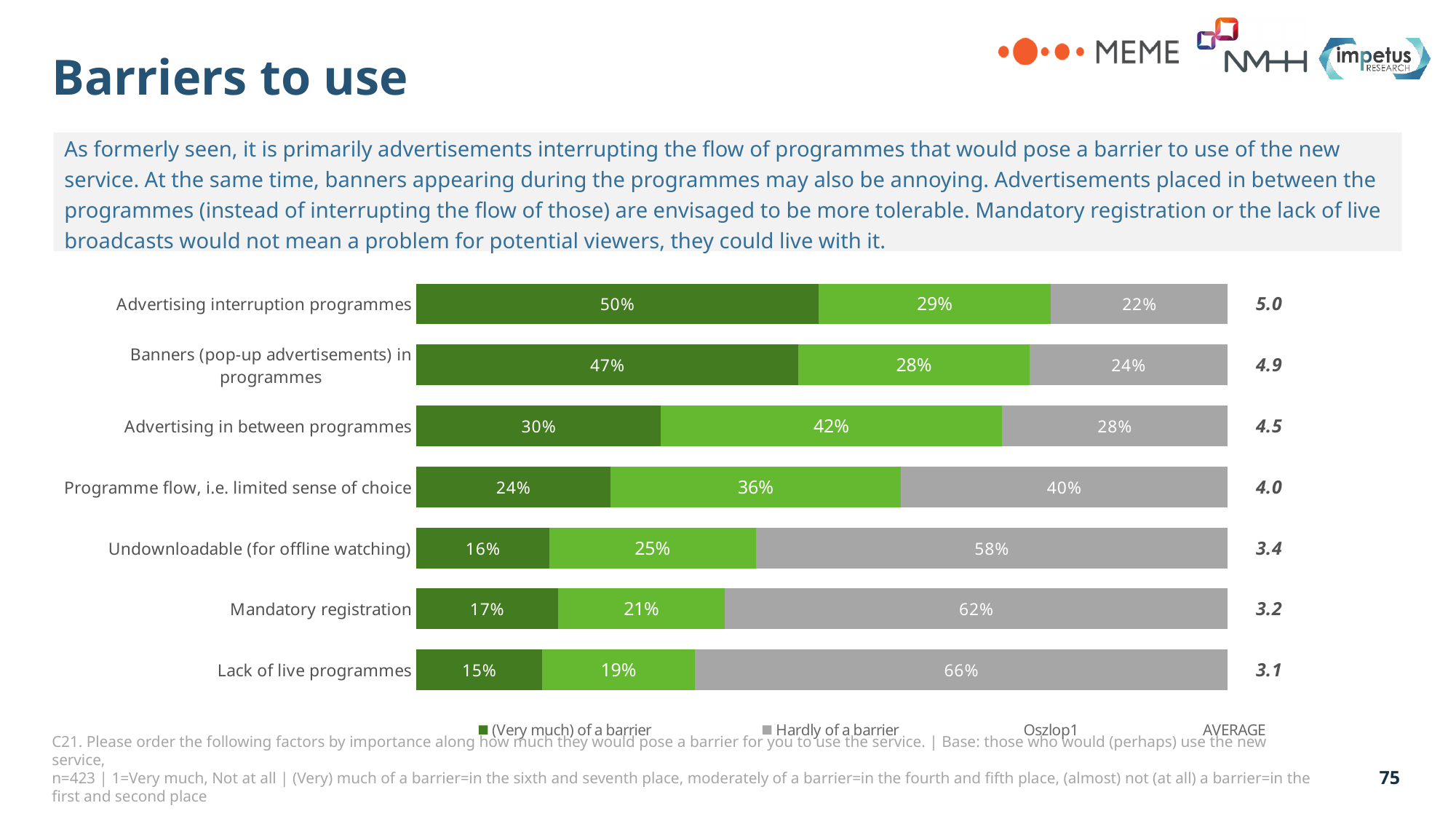
What is the value of the middle (light green) segment for 'Advertising in between programmes'? 42% What is the average score shown for 'Undownloadable (for offline watching)'? 3.4 What type of chart is shown on the slide? Stacked bar chart How many categories (barriers) are plotted in the chart? 7 What percentage is shown in the grey 'Hardly of a barrier' segment for 'Mandatory registration'? 62% What percentage of respondents consider 'Advertising interruption programmes' (very much) of a barrier (dark green segment)? 50% What is the difference between the 'Hardly of a barrier' percentages for 'Lack of live programmes' and 'Advertising interruption programmes'? 44 percentage points Which category has the highest average score shown on the right of the chart? Advertising interruption programmes What colour is used for the '(Very much) of a barrier' segments? Dark green Which category has the smallest dark green '(Very much) of a barrier' share? Lack of live programmes Which has a larger '(Very much) of a barrier' share: 'Banners (pop-up advertisements) in programmes' or 'Programme flow, i.e. limited sense of choice'? Banners (pop-up advertisements) in programmes What is the average score shown for 'Lack of live programmes'? 3.1